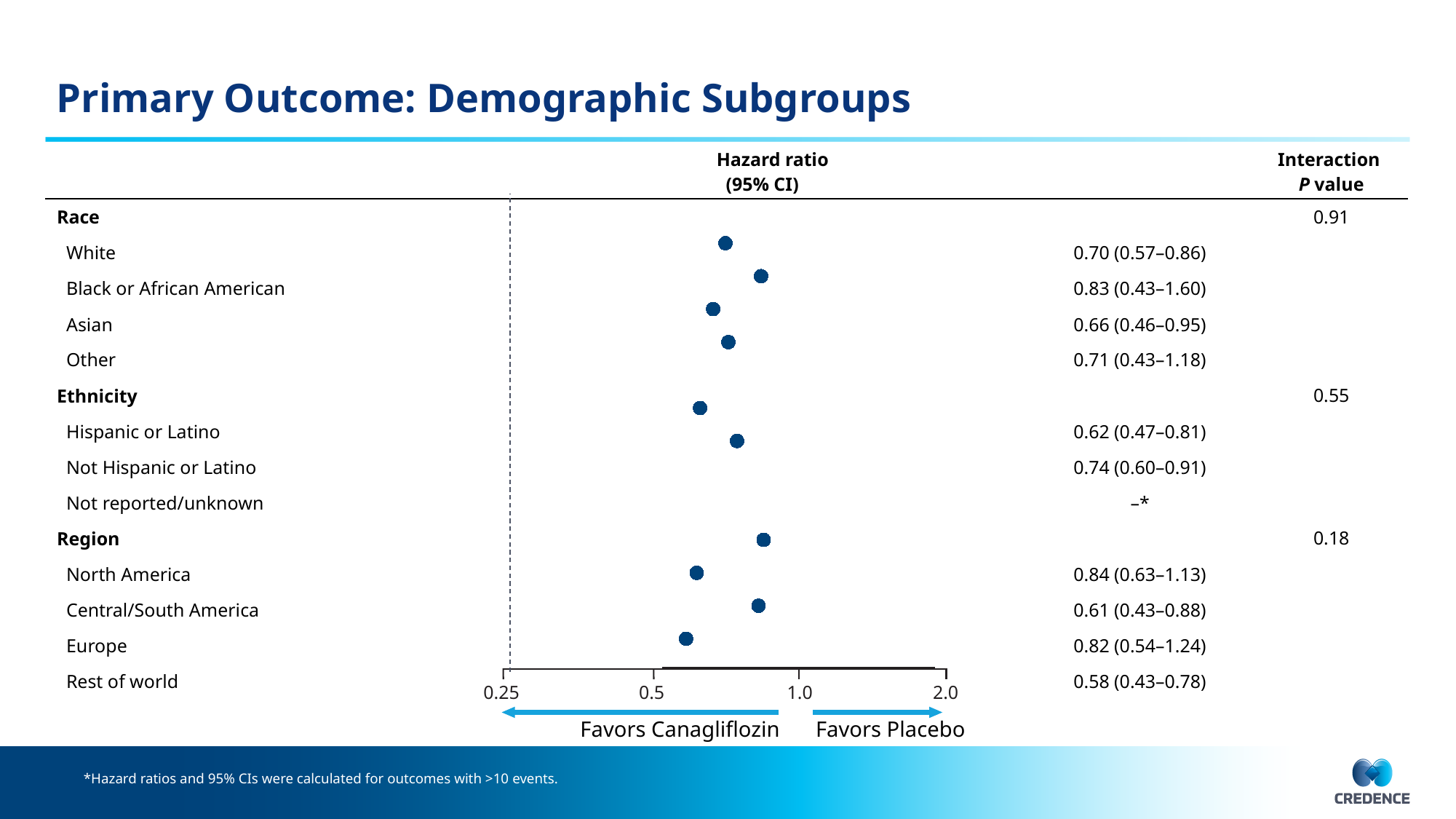
What is the interaction P value for Region? 0.18 Which subgroup has the lowest hazard ratio? Rest of world What is the interaction P value for Race? 0.91 What is the hazard ratio (95% CI) for the White subgroup? 0.70 (0.57–0.86) Is the hazard ratio for Asian greater or less than 1.0? less What does the left side of the hazard ratio axis favor, according to the label below the axis? Favors Canagliflozin What is the hazard ratio (95% CI) for the Rest of world subgroup? 0.58 (0.43–0.78) Which subgroup has the highest hazard ratio? North America What is the difference between the hazard ratios for North America and Rest of world? 0.26 How many subgroups have a hazard ratio reported on the slide? 10 What kind of chart is shown on the slide? Forest plot Which has the larger hazard ratio, Hispanic or Latino or Not Hispanic or Latino? Not Hispanic or Latino